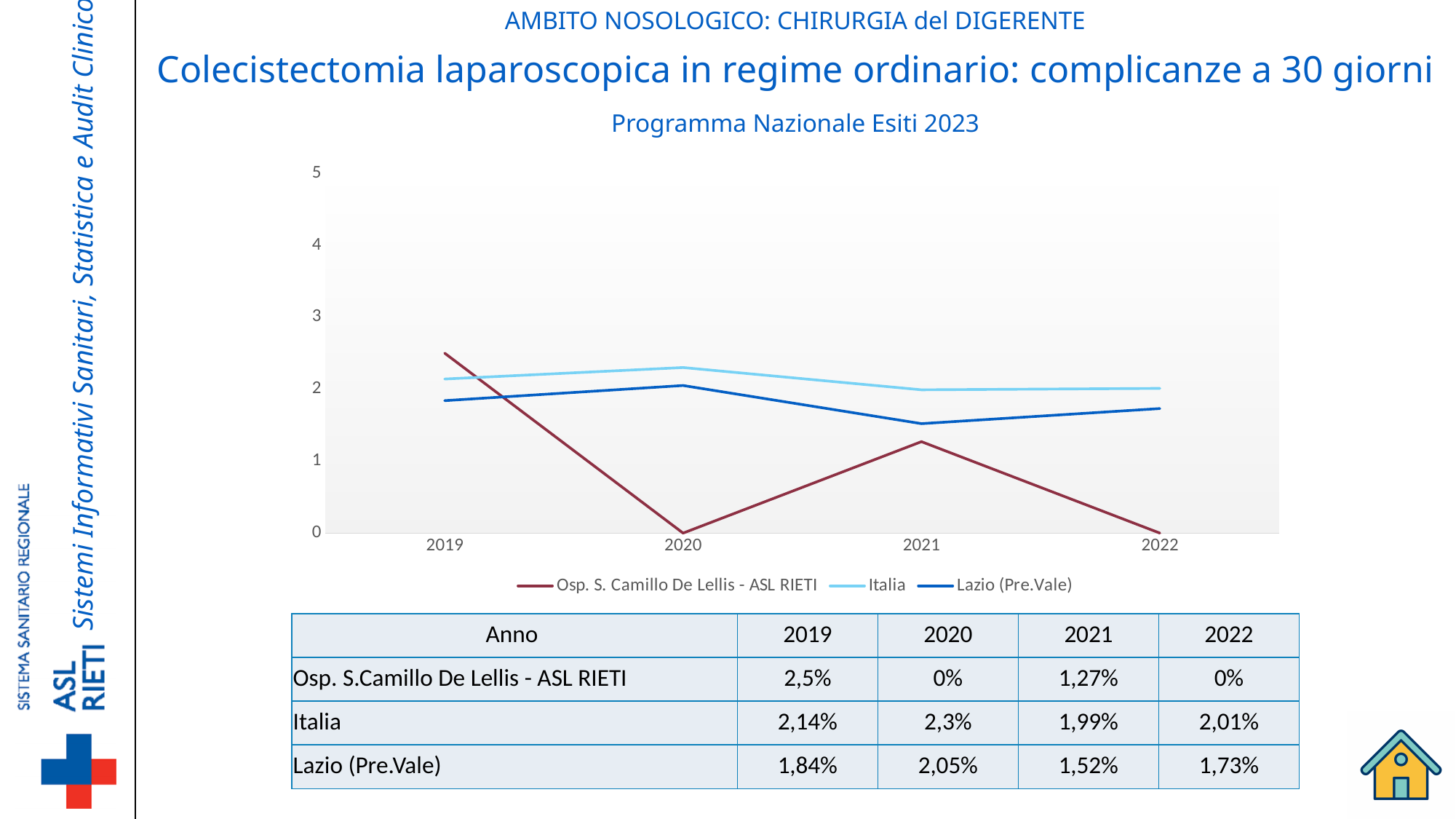
Does the value for Osp. S. Camillo De Lellis - ASL RIETI rise or fall from 2021 to 2022? fall Is the value for Osp. S. Camillo De Lellis - ASL RIETI in 2019 greater or less than 2? greater How many years are plotted along the x axis of the chart? 4 What kind of chart is shown on the slide? line chart In which year is the value for Lazio (Pre.Vale) lowest? 2021 What is the value for Italia in 2020? 2,3% What is the value for Lazio (Pre.Vale) in 2021? 1,52% In 2022, which is larger: the value for Italia or the value for Lazio (Pre.Vale)? Italia How many series does the chart legend list? 3 What is the difference between the Italia value and the Lazio (Pre.Vale) value in 2019? 0,3% What is the value for Osp. S. Camillo De Lellis - ASL RIETI in 2019? 2,5% In which year is the value for Italia highest? 2020